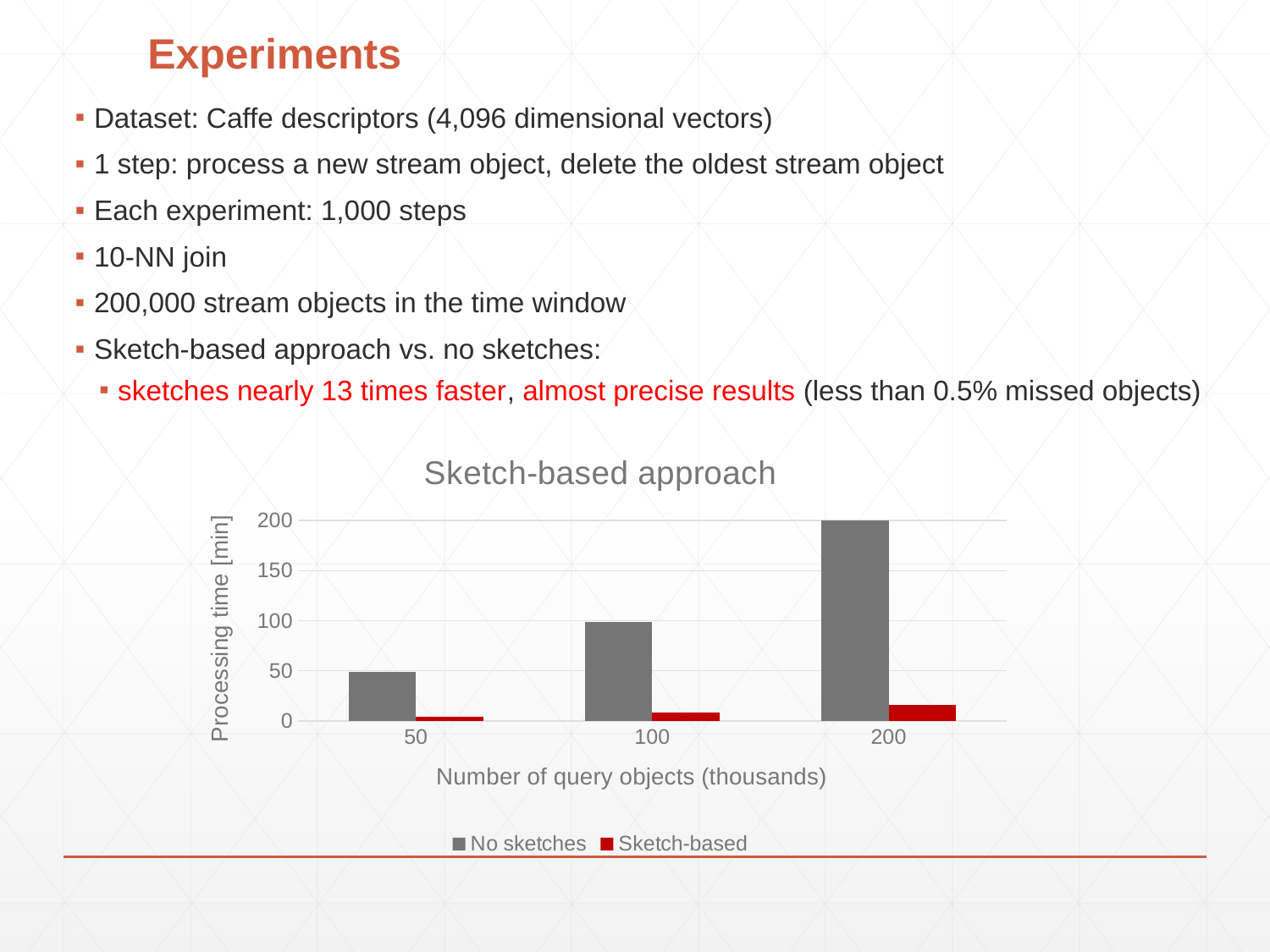
Which series has the larger value at 100 thousand query objects, No sketches or Sketch-based? No sketches How many series does the chart's legend list? 2 Is the Sketch-based value for 200 thousand query objects greater or less than 50? less Is the No sketches value for 200 thousand query objects greater or less than 150? greater Is the No sketches value for 100 thousand query objects greater or less than 50? greater What kind of chart is shown on the slide? bar chart For which number of query objects is the Sketch-based processing time lowest? 50 How many categories are shown on the x axis of the chart? 3 For which number of query objects is the No sketches processing time highest? 200 Which series is shown in red in the chart? Sketch-based What is the title of the chart? Sketch-based approach